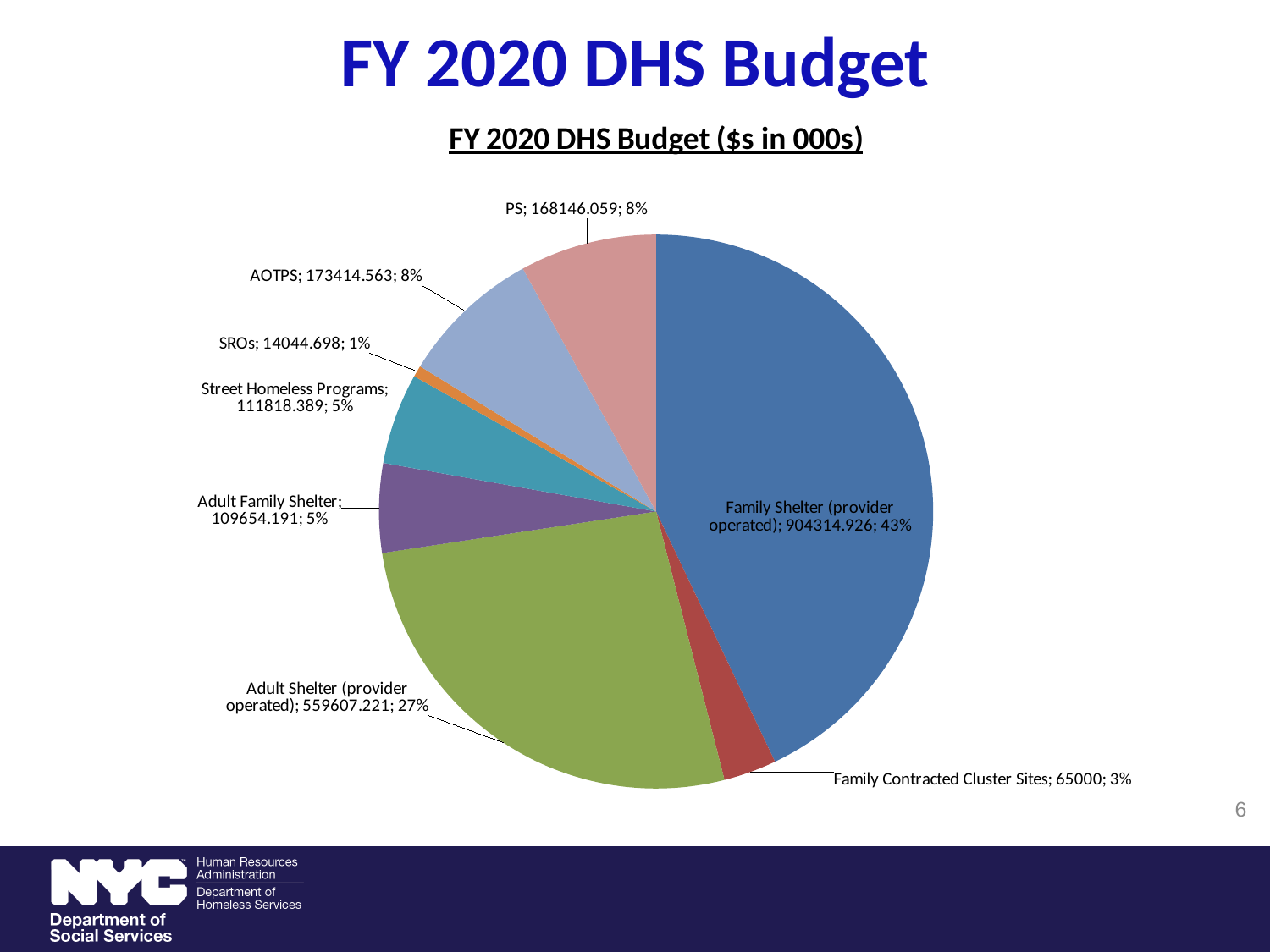
Which category has the smallest slice of the pie? SROs How many categories are shown in the pie chart? 8 What is the value for Adult Shelter (provider operated)? 559607.221 Which is larger, the value for AOTPS or the value for PS? AOTPS Which category has the largest slice of the pie? Family Shelter (provider operated) What is the value for SROs? 14044.698 What share of the pie does Adult Shelter (provider operated) represent? 27% What is the value for Family Contracted Cluster Sites? 65000 What type of chart is shown on the slide? Pie chart What is the difference between the values for Family Shelter (provider operated) and Adult Shelter (provider operated)? 344707.705 What is the value for Family Shelter (provider operated)? 904314.926 What share of the pie does Street Homeless Programs represent? 5%